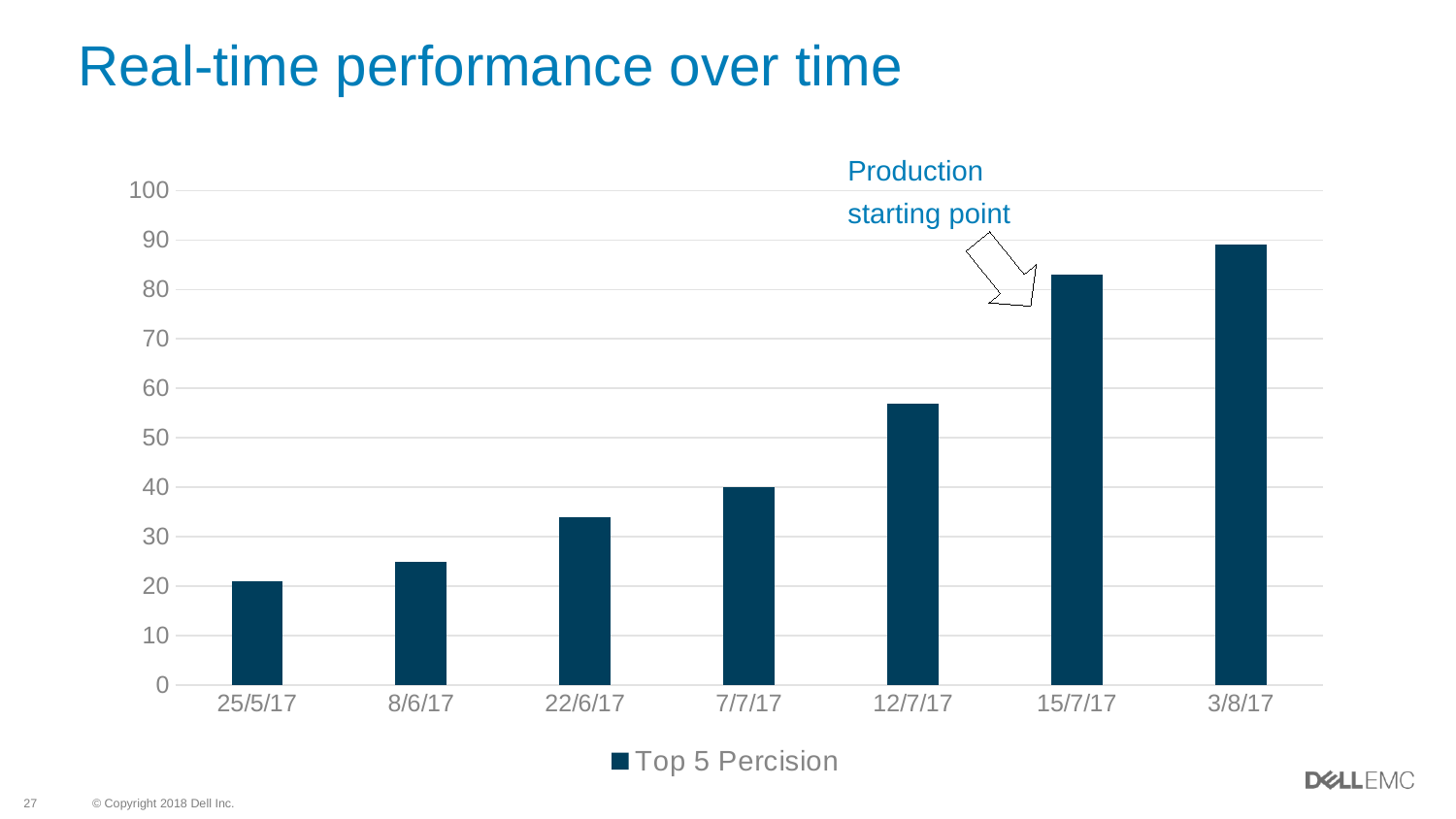
Which has a larger Top 5 Percision value, 22/6/17 or 12/7/17? 12/7/17 Which date has the highest Top 5 Percision value? 3/8/17 What kind of chart is shown on the slide? bar chart Do the Top 5 Percision values rise or fall from 25/5/17 to 3/8/17? rise Is the Top 5 Percision value for 12/7/17 greater or less than 50? greater Which date has the lowest Top 5 Percision value? 25/5/17 Is the Top 5 Percision value for 15/7/17 greater or less than 80? greater Which date does the 'Production starting point' arrow point to? 15/7/17 Is the Top 5 Percision value for 25/5/17 greater or less than 30? less What is the name of the series shown in the chart legend? Top 5 Percision How many series does the chart legend list? 1 How many dates are shown on the x axis of the chart? 7